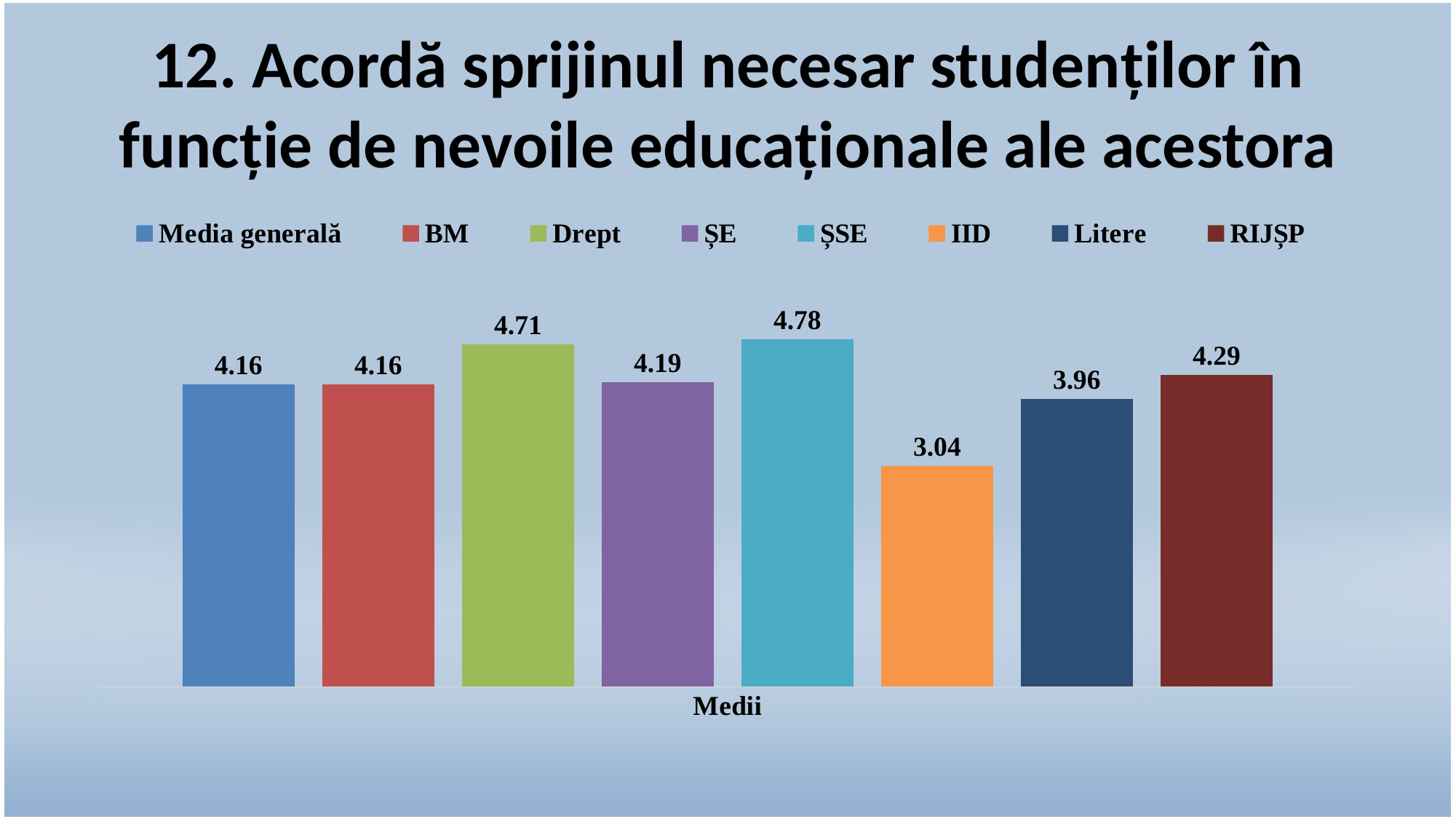
Which series has the lowest value? IID What is the difference between the values for Drept and Litere? 0.75 What is the value for ȘSE? 4.78 How many series does the legend list? 8 What is the difference between the values for ȘSE and IID? 1.74 What kind of chart is shown on the slide? Bar chart Which series has the highest value? ȘSE What is the value for Media generală? 4.16 Which is larger, the value for RIJȘP or the value for ȘE? RIJȘP What is the label on the x axis of the chart? Medii What is the value for IID? 3.04 What is the value for Litere? 3.96